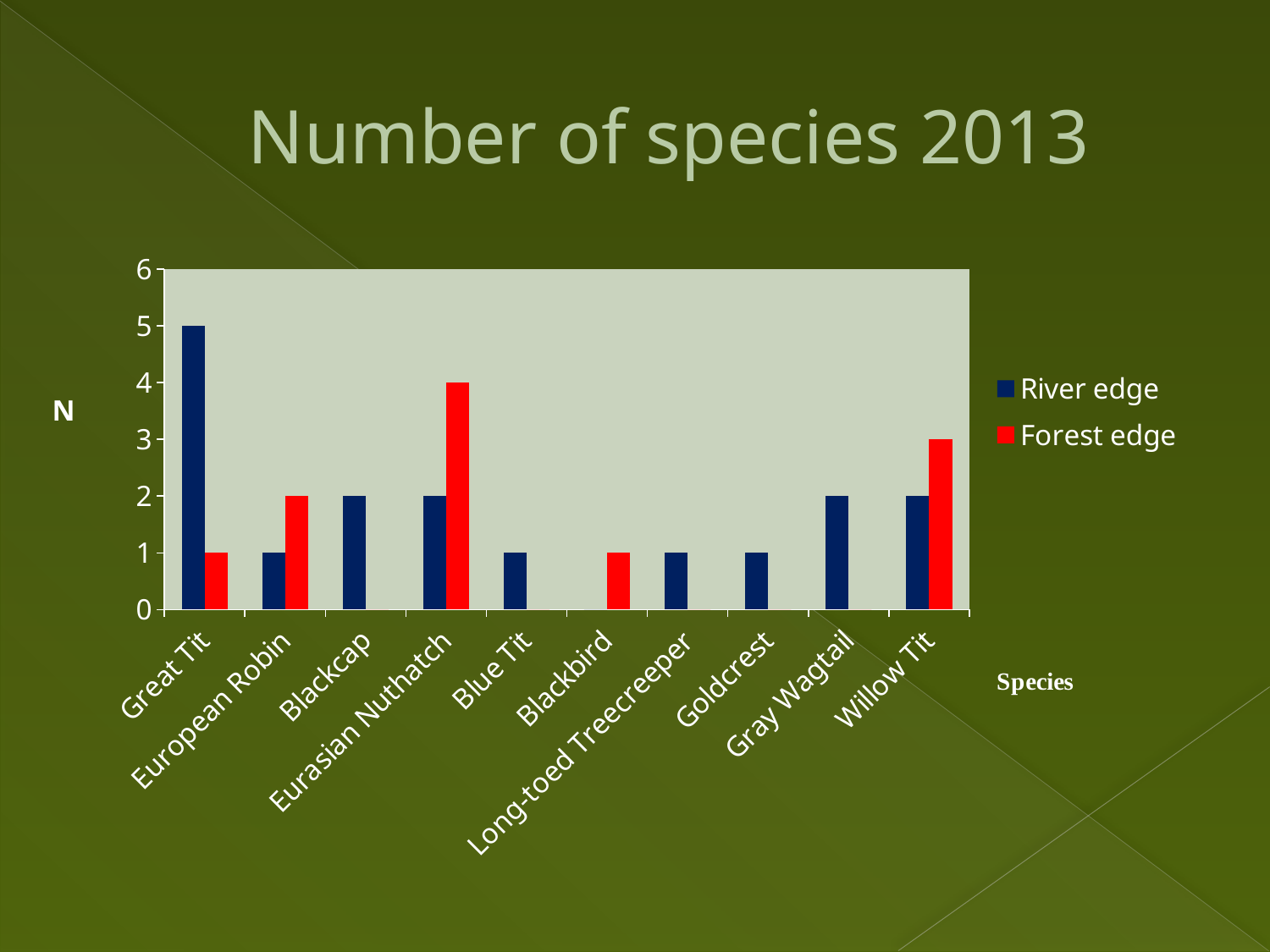
What is the difference between the River edge and Forest edge values for Great Tit? 4 What type of chart is shown on the slide? Bar chart What is the Forest edge value for Willow Tit? 3 How many species categories are shown on the x axis? 10 How many series does the legend list? 2 What is the River edge value for Great Tit? 5 For European Robin, which is larger: the River edge value or the Forest edge value? Forest edge What is the title of the chart? Number of species 2013 What is the Forest edge value for Eurasian Nuthatch? 4 Which species has the highest Forest edge value? Eurasian Nuthatch Which species has the highest River edge value? Great Tit What colour represents the Forest edge series? Red